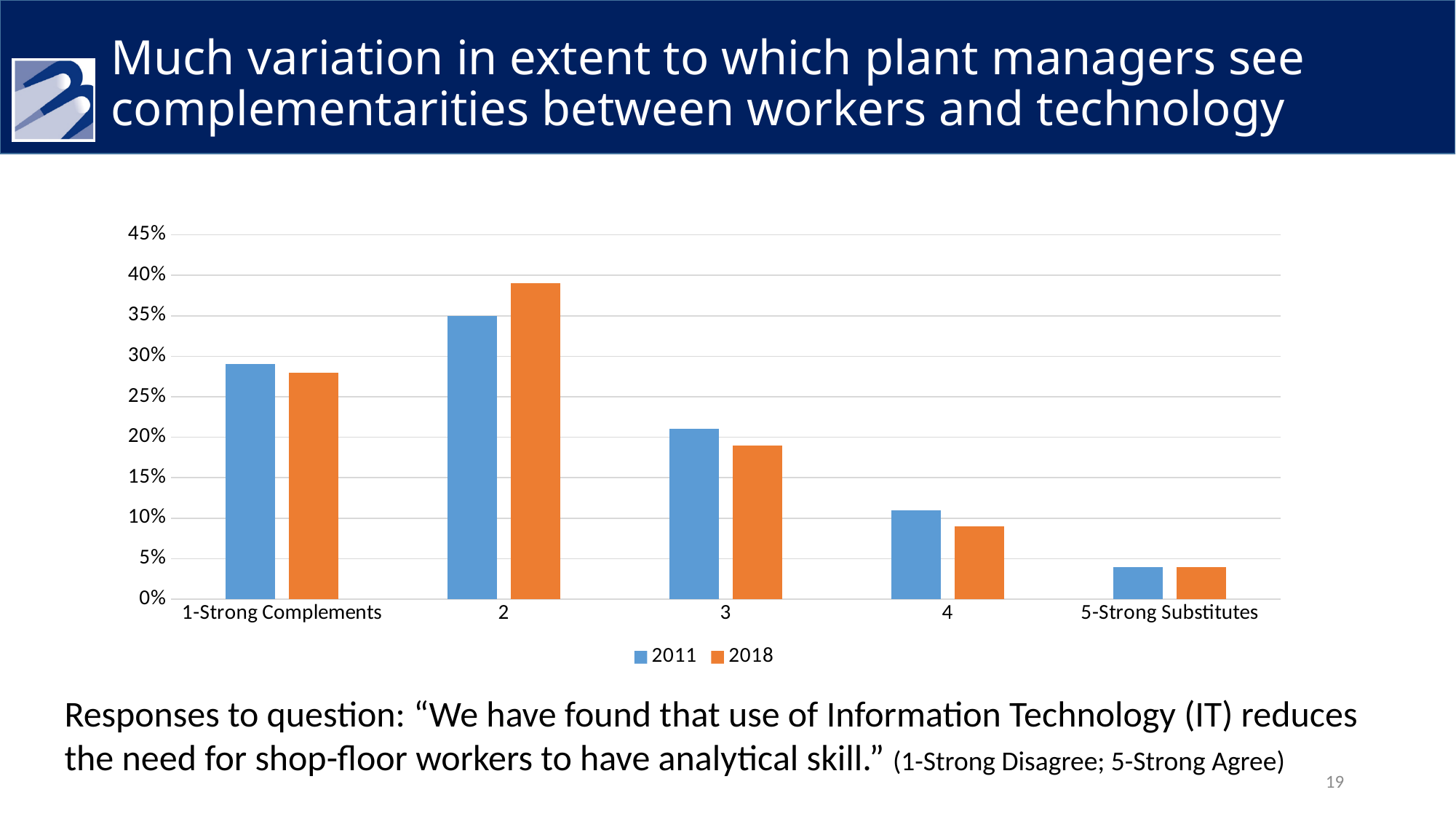
Is the 2011 value for 1-Strong Complements greater or less than 25%? greater For category 3, which series has the larger value, 2011 or 2018? 2011 Which category has the highest value for the 2018 series? 2 Which category has the lowest value for the 2011 series? 5-Strong Substitutes How many series does the legend list? 2 Is the 2018 value for category 2 greater or less than 35%? greater For category 2, which series has the larger value, 2011 or 2018? 2018 Is the 2011 value for category 4 greater or less than 15%? less What kind of chart is shown on the slide? bar chart Which series is shown in orange? 2018 Do the 2018 values rise or fall from category 2 to 5-Strong Substitutes? fall How many response categories are shown on the x axis? 5